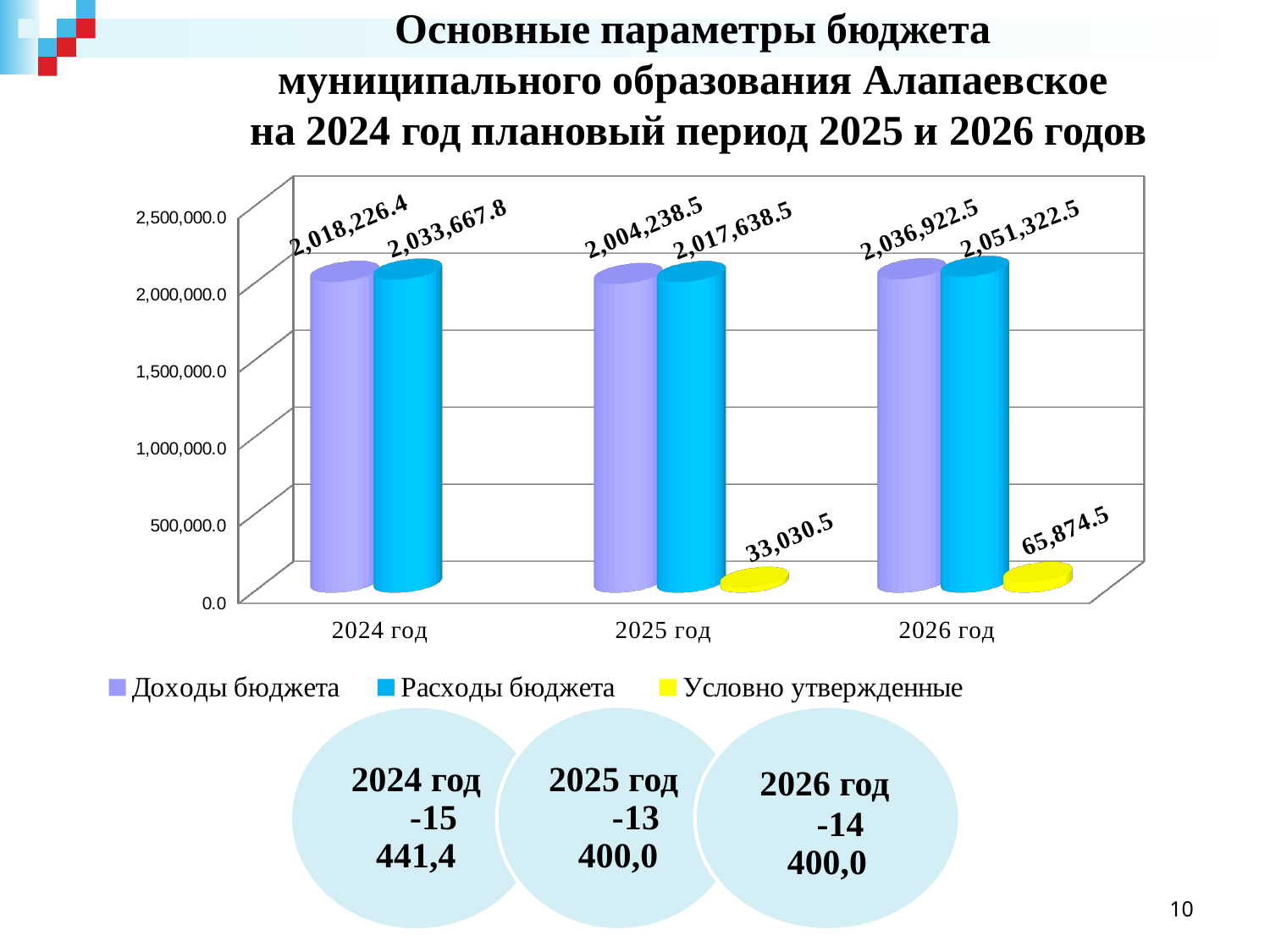
In which year is Доходы бюджета the highest? 2026 год In which year is Расходы бюджета the lowest? 2025 год How many years are shown on the x axis of the chart? 3 What is the difference between Условно утвержденные for 2026 год and for 2025 год? 32,844.0 What is the value of Условно утвержденные for 2025 год? 33,030.5 How many series does the legend list? 3 For 2024 год, which is larger: Доходы бюджета or Расходы бюджета? Расходы бюджета What is the difference between Расходы бюджета and Доходы бюджета for 2025 год? 13,400.0 Is the value of Условно утвержденные for 2026 год greater or less than 500,000.0? less What is the value of Доходы бюджета for 2024 год? 2,018,226.4 What is the value of Расходы бюджета for 2026 год? 2,051,322.5 What kind of chart is shown on the slide? bar chart